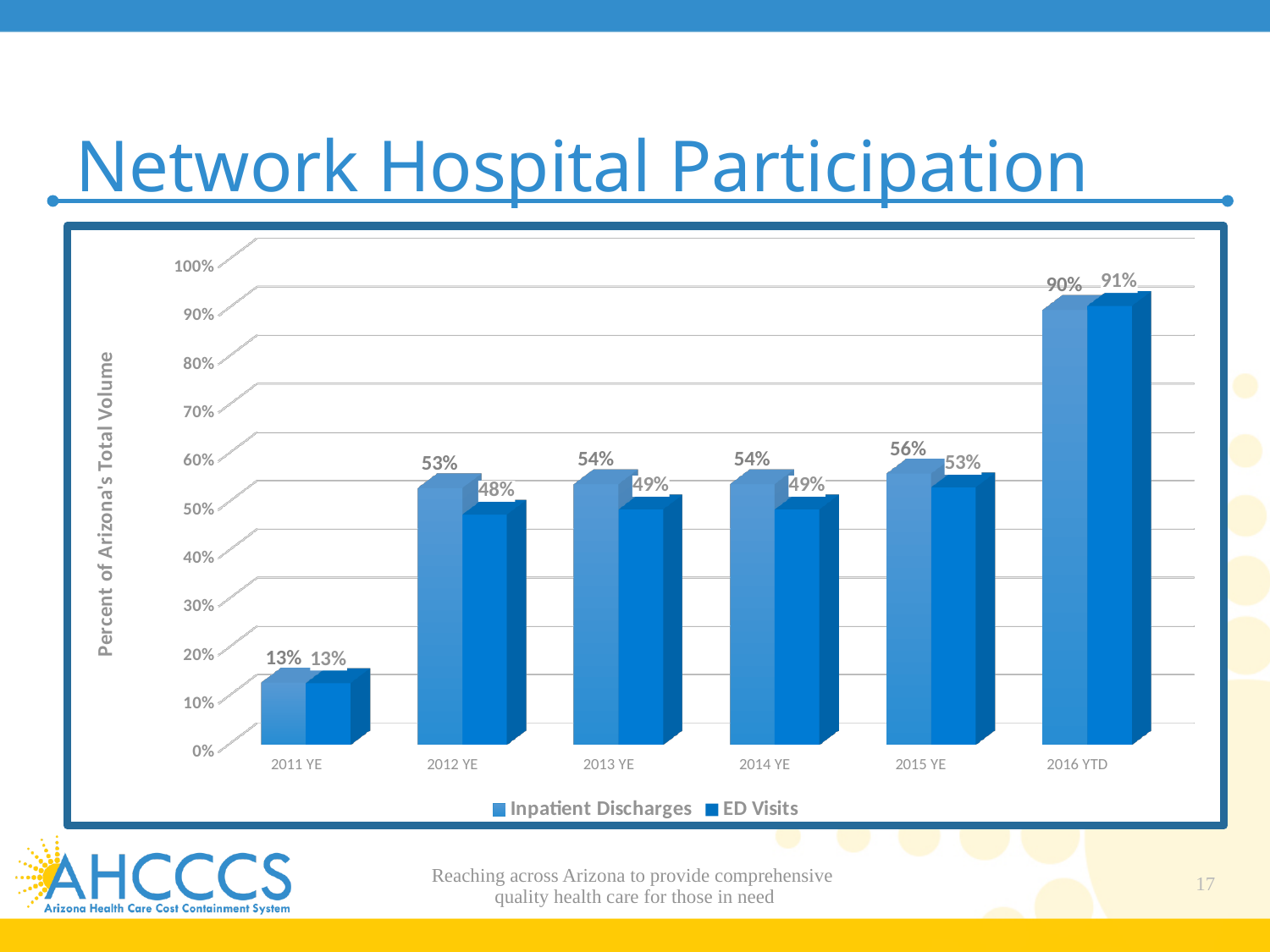
What kind of chart is shown on the slide? Bar chart What is the ED Visits value for 2016 YTD? 91% What is the difference between Inpatient Discharges and ED Visits in 2012 YE? 5% Which year has the lowest ED Visits value? 2011 YE How many year categories are shown on the x axis? 6 Which year has the highest Inpatient Discharges value? 2016 YTD What is the Inpatient Discharges value for 2012 YE? 53% Which is larger in 2016 YTD, Inpatient Discharges or ED Visits? ED Visits Is the Inpatient Discharges value for 2015 YE greater or less than 50%? greater What is the label of the vertical axis? Percent of Arizona's Total Volume What is the ED Visits value for 2015 YE? 53% How many series does the legend list? 2